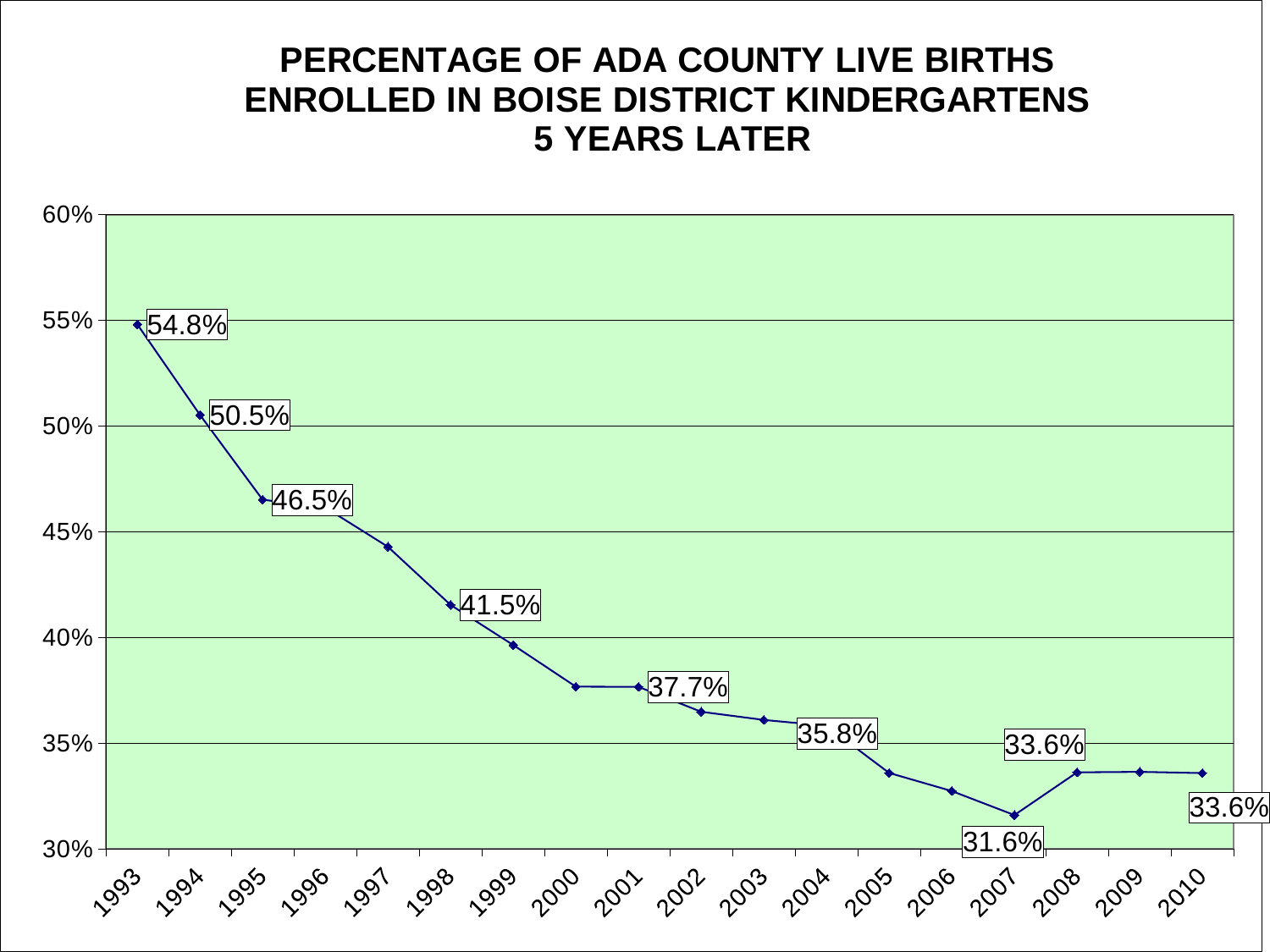
By how many percentage points did the value fall from 1993 to 2010? 21.2 percentage points Overall, do the values rise or fall from 1993 to 2010? Fall What is the value shown for 2001? 37.7% What is the value shown for 1998? 41.5% What percentage of Ada County live births were enrolled in Boise District kindergartens 5 years later for 1993? 54.8% Which year has the larger value, 1994 or 1995? 1994 How many years are plotted on the x axis? 18 Is the value for 1997 greater or less than 40%? greater What kind of chart is shown on the slide? Line chart Which year has the highest percentage on the chart? 1993 What is the value shown for 2007? 31.6% Which year has the lowest percentage on the chart? 2007